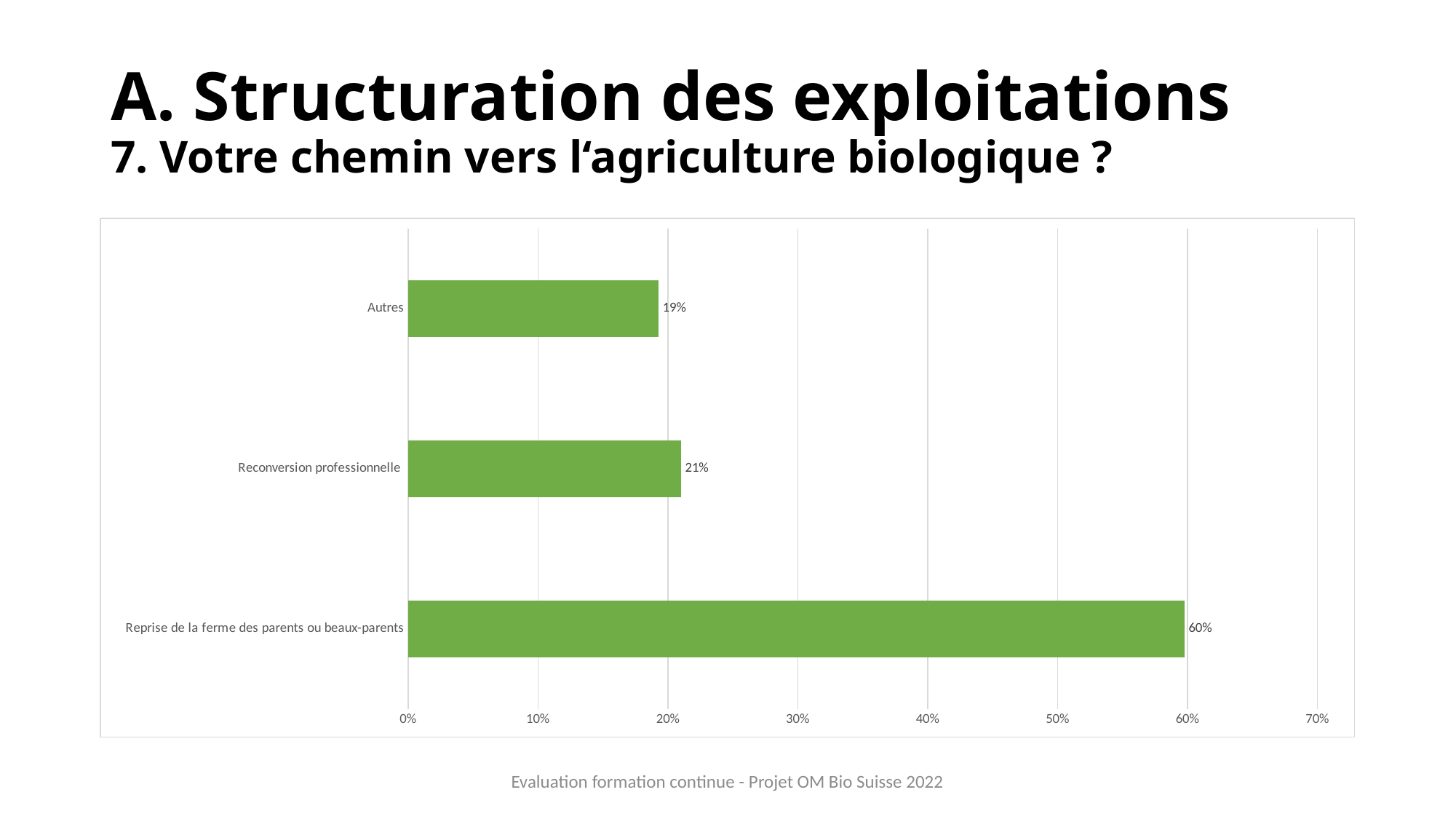
Which is larger: the value for "Reprise de la ferme des parents ou beaux-parents" or the value for "Autres"? Reprise de la ferme des parents ou beaux-parents What is the value for "Autres"? 19% How many categories are shown in the chart? 3 What is the value for "Reprise de la ferme des parents ou beaux-parents"? 60% What kind of chart is shown on the slide? bar chart What is the difference between the values for "Reprise de la ferme des parents ou beaux-parents" and "Reconversion professionnelle"? 39% What is the value for "Reconversion professionnelle"? 21% What is the difference between the values for "Reconversion professionnelle" and "Autres"? 2% Is the value for "Reconversion professionnelle" greater or less than 30%? less Which category has the highest value? Reprise de la ferme des parents ou beaux-parents Which category has the lowest value? Autres What is the highest value shown on the x axis? 70%